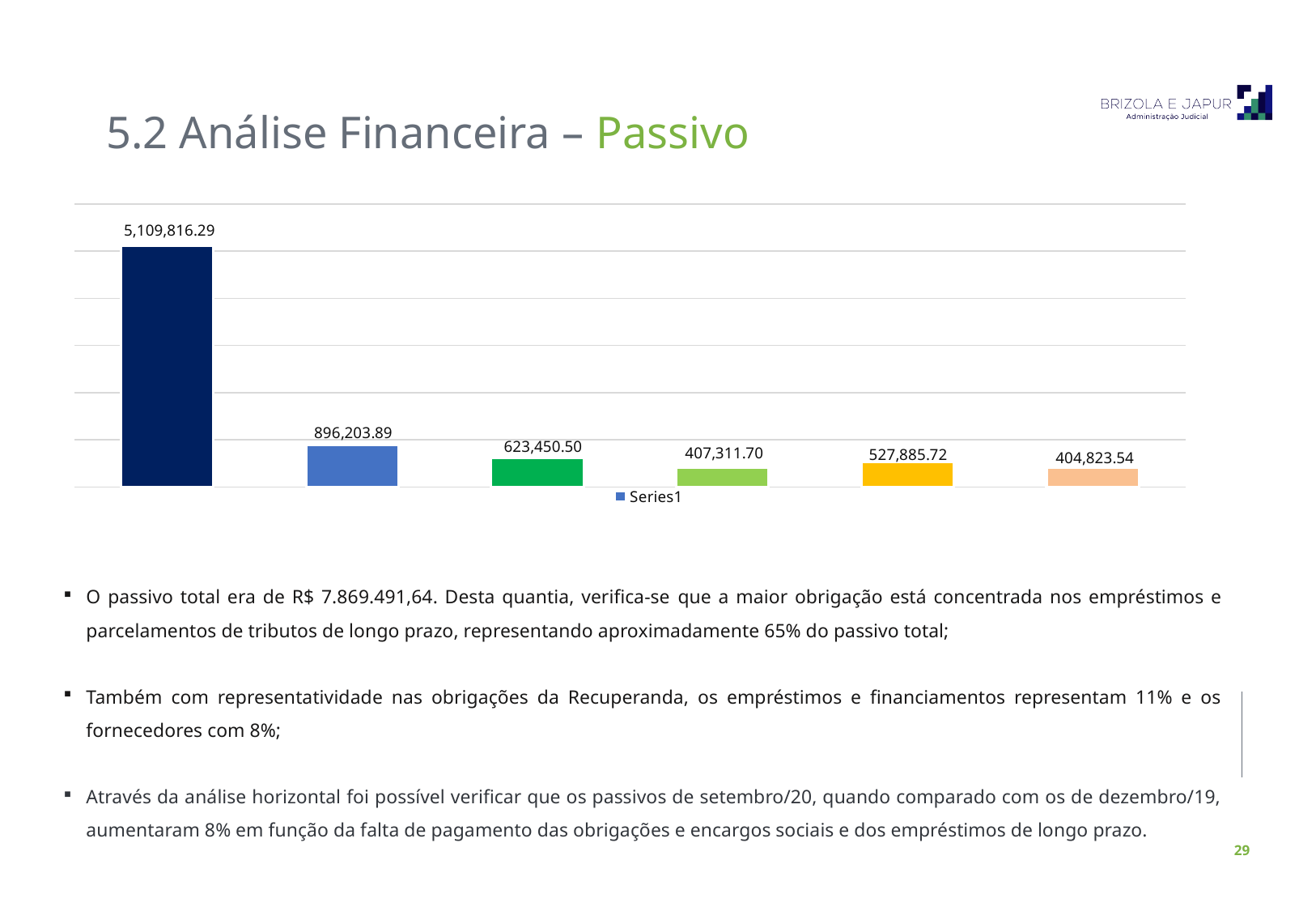
What is the value shown on the fifth (yellow) bar? 527,885.72 What is the difference between the second bar (896,203.89) and the third bar (623,450.50)? 272,753.39 What is the value shown on the second (blue) bar? 896,203.89 Which bar has the highest value in the chart? the first (dark blue) bar, 5,109,816.29 How many series does the chart legend list? 1 What is the name of the series shown in the chart legend? Series1 What is the value shown on the first (leftmost, dark blue) bar? 5,109,816.29 How many bars are plotted in the chart? 6 What type of chart is shown on the slide? bar chart Which bar has the lowest value in the chart? the last (orange) bar, 404,823.54 What is the value shown on the last (rightmost, orange) bar? 404,823.54 What is the value shown on the third (green) bar? 623,450.50